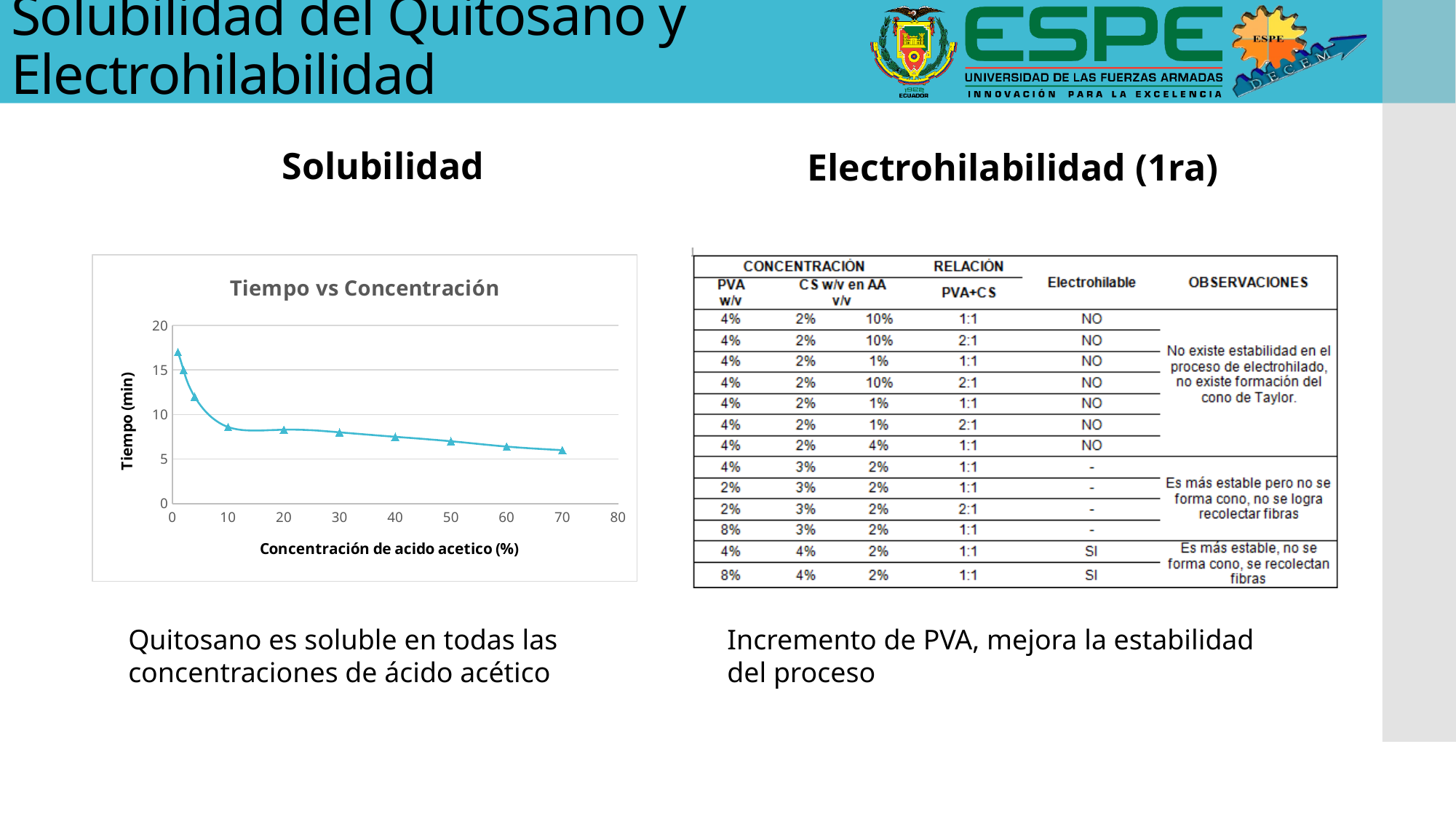
In the "Tiempo vs Concentración" chart, is the value at a concentration of 50% greater or less than 10? less In the "Tiempo vs Concentración" chart, at which concentration on the x axis is the time lowest? 70 What kind of chart is "Tiempo vs Concentración"? line chart In the "Tiempo vs Concentración" chart, is the first plotted value (at the lowest concentration) greater or less than 15? greater In the "Tiempo vs Concentración" chart, is the value at a concentration of 70% greater or less than 10? less In the "Tiempo vs Concentración" chart, which is larger: the value at 10% concentration or the value at 70% concentration? 10% How many data points are plotted in the "Tiempo vs Concentración" chart? 10 What is the title of the chart on the slide? Tiempo vs Concentración What is the label of the y axis in the "Tiempo vs Concentración" chart? Tiempo (min) In the "Tiempo vs Concentración" chart, do the values rise or fall as the concentration increases along the x axis? fall